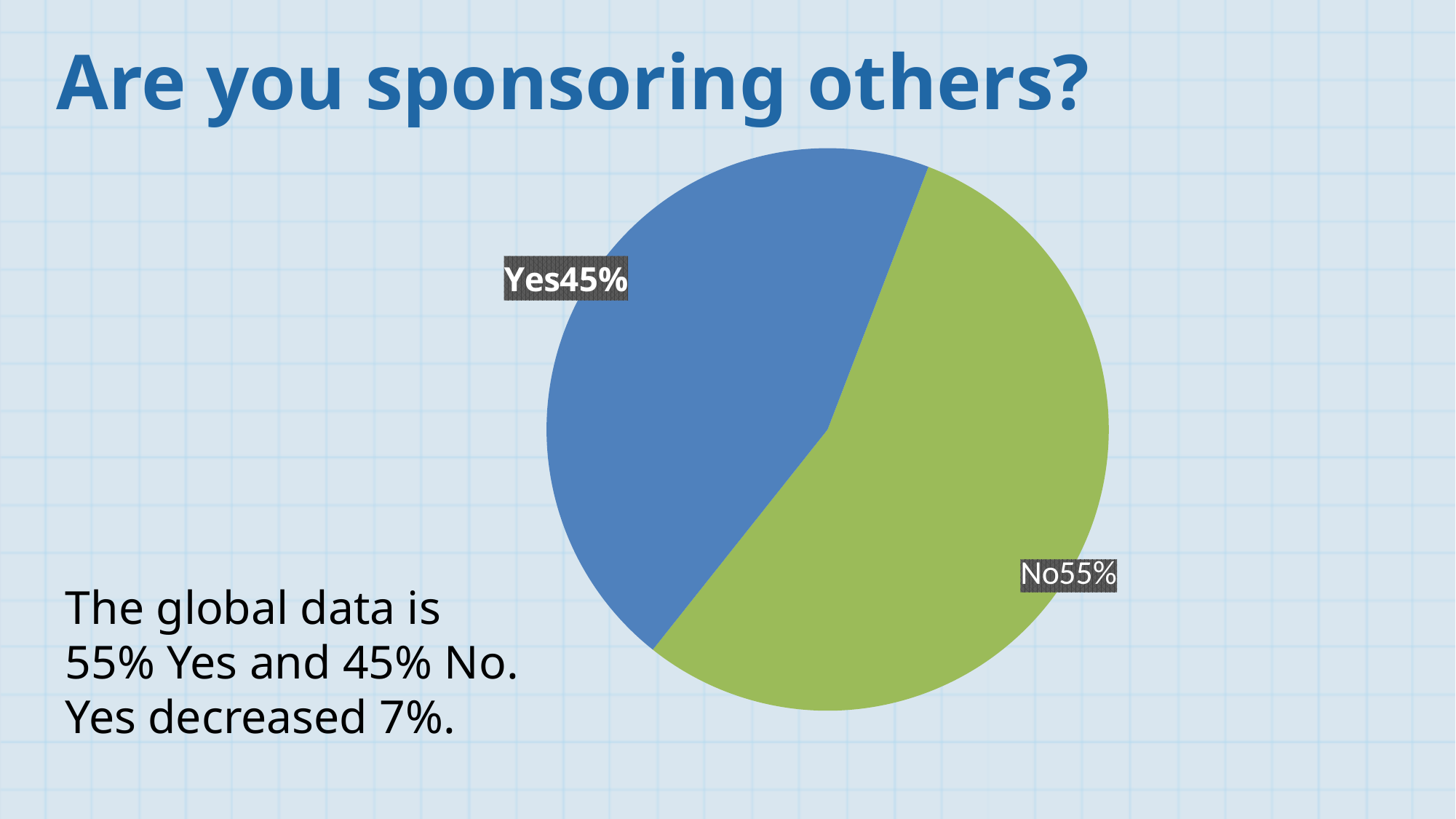
Which slice of the pie chart is the largest? No What share of the pie does the Yes slice represent? 45% Which slice of the pie chart is the smallest? Yes Which slice is larger, Yes or No? No What colour is the No slice of the pie chart? green What percentage of the pie chart is labelled Yes? 45% What is the difference in percentage points between the No slice and the Yes slice? 10% What is the total of the two slices shown in the pie chart? 100% How many slices does the pie chart have? 2 What is the title of the slide containing the pie chart? Are you sponsoring others? What kind of chart is shown on the slide? pie chart What percentage of the pie chart is labelled No? 55%